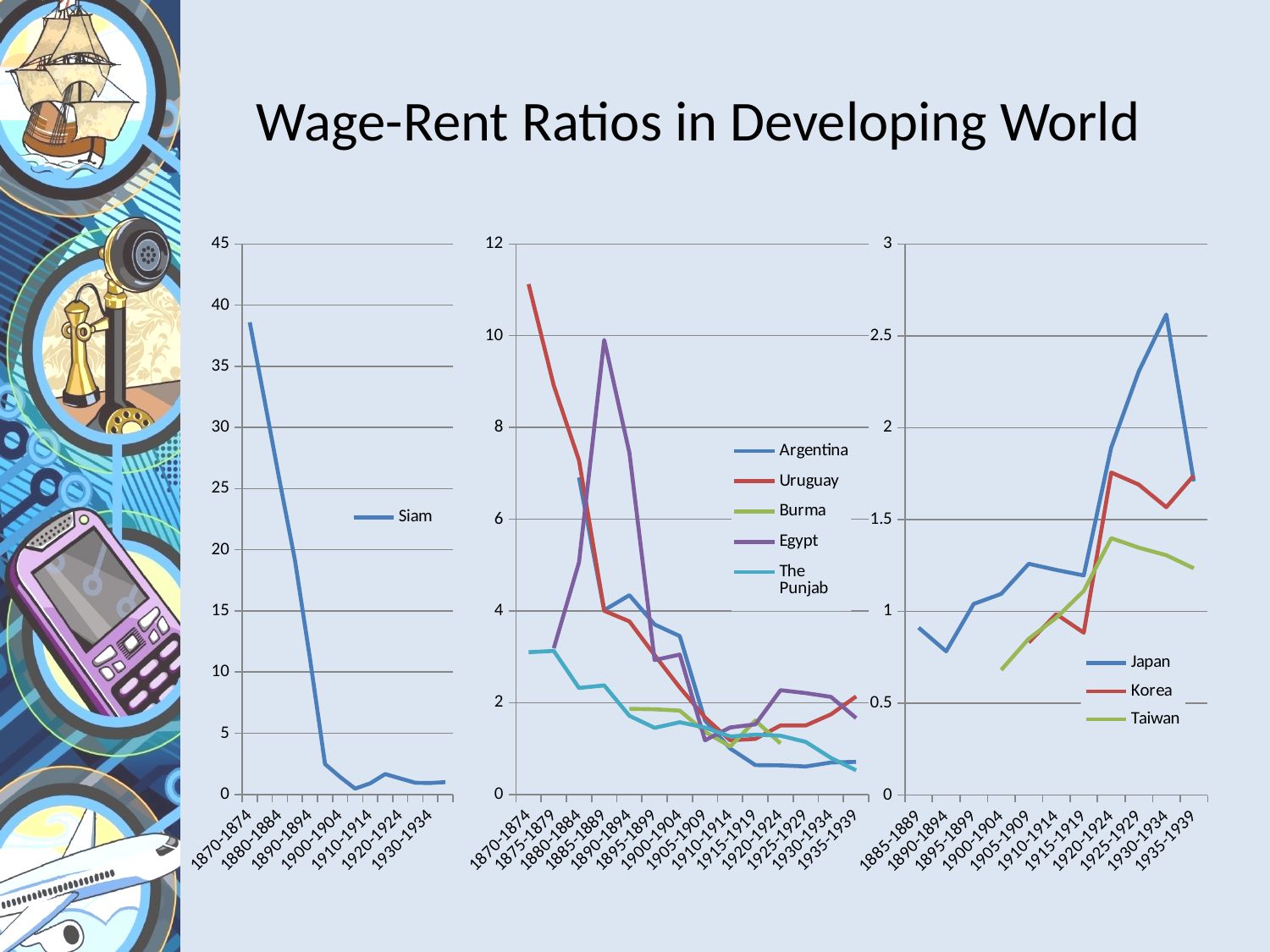
In the middle chart, which series has the highest value in 1870-1874? Uruguay In the left chart, does the value for Siam rise or fall from 1870-1874 to 1930-1934? fall In the right chart, which series has the highest value in 1930-1934? Japan How many series does the legend of the middle chart list? 5 In the left chart, is the value for Siam in 1870-1874 greater or less than 35? greater What kind of chart is the left chart showing Siam? line chart What is the title of the slide containing the three charts? Wage-Rent Ratios in Developing World In the right chart, is the value for Japan in 1930-1934 greater or less than 2.5? greater How many series does the legend of the right chart list? 3 In the middle chart, is the value for Uruguay in 1870-1874 greater or less than 10? greater In the middle chart, which is larger in 1885-1889, Argentina or The Punjab? Argentina